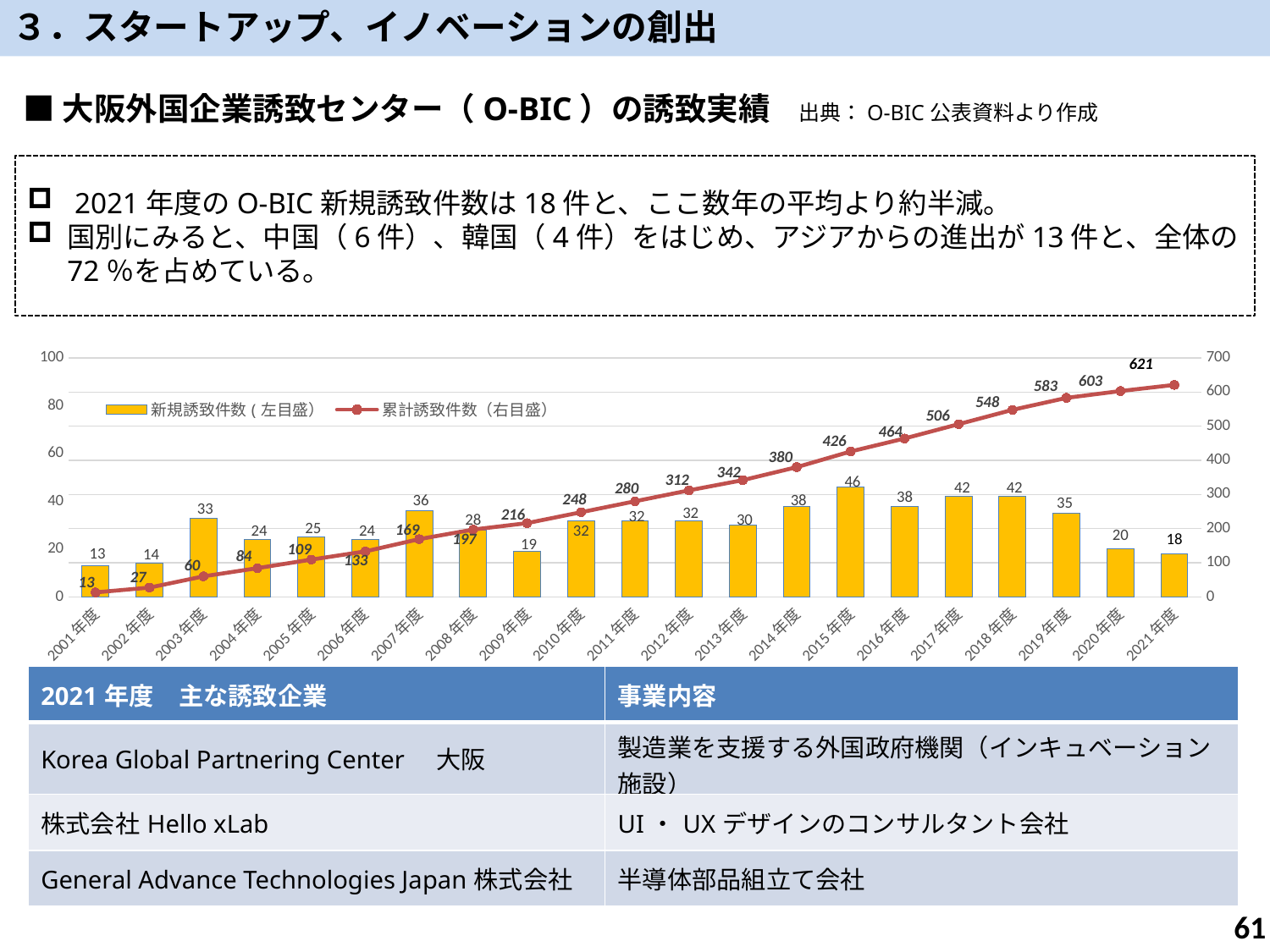
What is the value of 累計誘致件数 (right axis) for 2021年度? 621 Which is larger, the 新規誘致件数 for 2003年度 or for 2019年度? 2019年度 Which year has the highest 新規誘致件数? 2015年度 What is the difference in 新規誘致件数 between 2015年度 and 2021年度? 28 What is the value of 累計誘致件数 for 2010年度? 248 How many series does the legend list? 2 Which year has the lowest 新規誘致件数? 2001年度 What colour are the 新規誘致件数 bars? yellow (orange-yellow) What is the value of 新規誘致件数 (left axis) for 2021年度? 18 Does the 累計誘致件数 line rise or fall from 2001年度 to 2021年度? rise What is the value of 新規誘致件数 for 2007年度? 36 How many years (categories) are shown on the x axis? 21